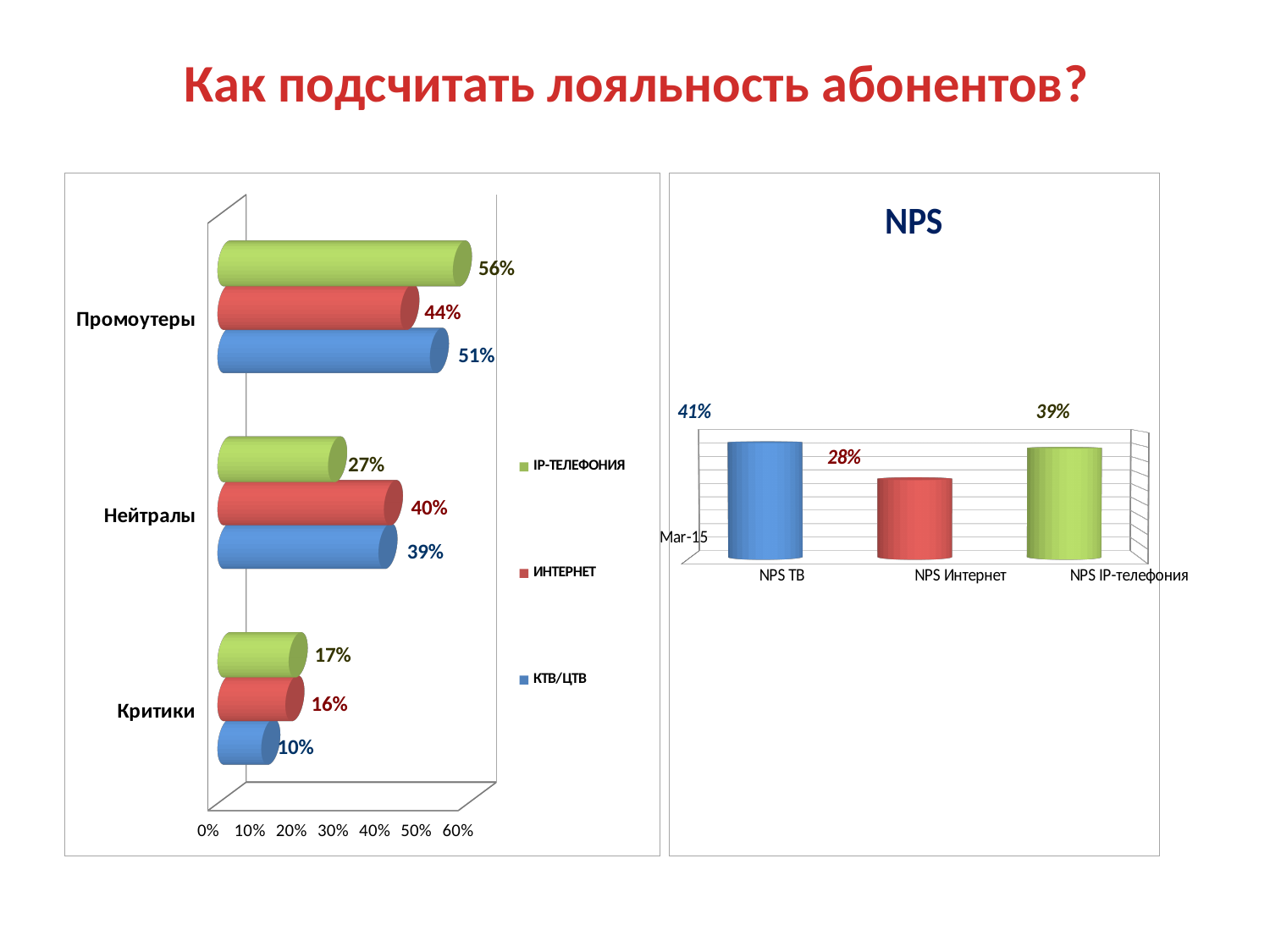
What kind of chart is the NPS chart? Bar chart In the left chart, what is the value for IP-ТЕЛЕФОНИЯ in the Промоутеры category? 56% How many series does the legend of the left chart list? 3 In the left chart, what is the value for КТВ/ЦТВ in the Критики category? 10% In the left chart, what is the difference between the IP-ТЕЛЕФОНИЯ and ИНТЕРНЕТ values in the Нейтралы category? 13% In the left chart, which series has the highest value in the Промоутеры category? IP-ТЕЛЕФОНИЯ In the NPS chart, which category has the highest value? NPS ТВ In the left chart, what is the value for ИНТЕРНЕТ in the Нейтралы category? 40% In the NPS chart, what is the value for NPS Интернет? 28% In the left chart, which is larger for Промоутеры: ИНТЕРНЕТ or КТВ/ЦТВ? КТВ/ЦТВ In the NPS chart, what is the difference between NPS ТВ and NPS IP-телефония? 2% In the left chart, which series has the lowest value in the Критики category? КТВ/ЦТВ